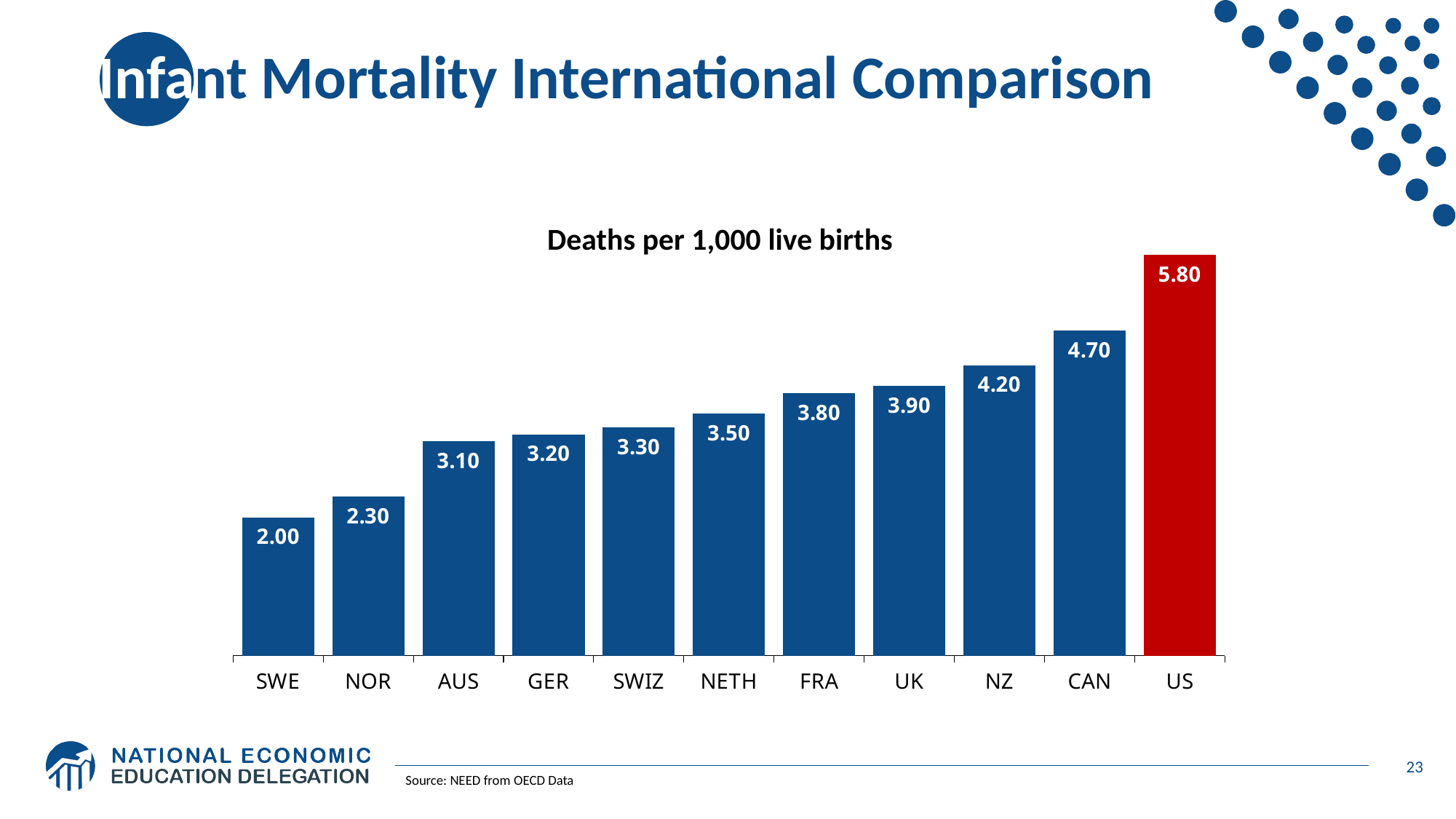
Do the values rise or fall from left to right along the x axis? Rise Which bar is coloured red rather than blue? US What is the value for NETH? 3.50 What kind of chart is shown on the slide? Bar chart What is the value for SWE? 2.00 Which has a higher value, UK or FRA? UK Which country has the lowest deaths per 1,000 live births? SWE Which country has the highest deaths per 1,000 live births? US What is the difference between the values for the US and CAN? 1.10 What is the difference between the values for NOR and SWE? 0.30 How many countries are shown on the chart? 11 What is the value for the US? 5.80